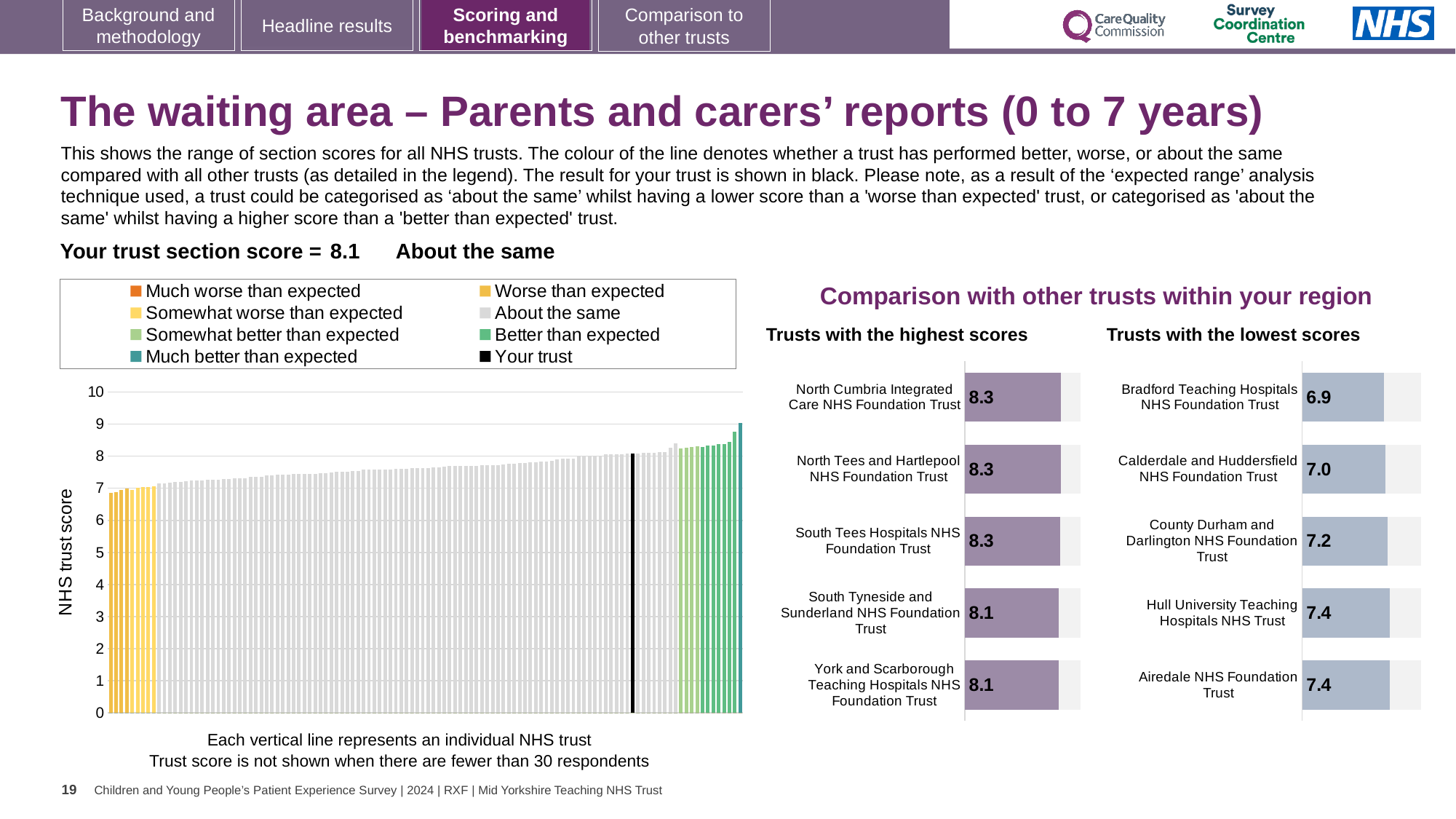
In the 'Trusts with the lowest scores' chart, what is the score for County Durham and Darlington NHS Foundation Trust? 7.2 In the 'Trusts with the highest scores' chart, what is the difference between the scores of South Tees Hospitals NHS Foundation Trust and South Tyneside and Sunderland NHS Foundation Trust? 0.2 In the 'Trusts with the lowest scores' chart, which has the higher score: Calderdale and Huddersfield NHS Foundation Trust or Hull University Teaching Hospitals NHS Trust? Hull University Teaching Hospitals NHS Trust In the 'NHS trust score' chart on the left, do the bar values rise or fall from left to right? Rise In the 'Trusts with the highest scores' chart, what is the score for York and Scarborough Teaching Hospitals NHS Foundation Trust? 8.1 How many trusts are listed in the 'Trusts with the highest scores' chart? 5 In the 'Trusts with the highest scores' chart, what is the score for North Cumbria Integrated Care NHS Foundation Trust? 8.3 How many entries does the legend of the 'NHS trust score' chart on the left list? 8 What type of chart is the 'NHS trust score' chart on the left of the slide? Bar chart In the 'Trusts with the lowest scores' chart, which trust has the lowest score? Bradford Teaching Hospitals NHS Foundation Trust In the 'NHS trust score' chart on the left, is the value of the tallest bar greater or less than 8? greater In the 'Trusts with the lowest scores' chart, what is the difference between the scores of Airedale NHS Foundation Trust and Bradford Teaching Hospitals NHS Foundation Trust? 0.5